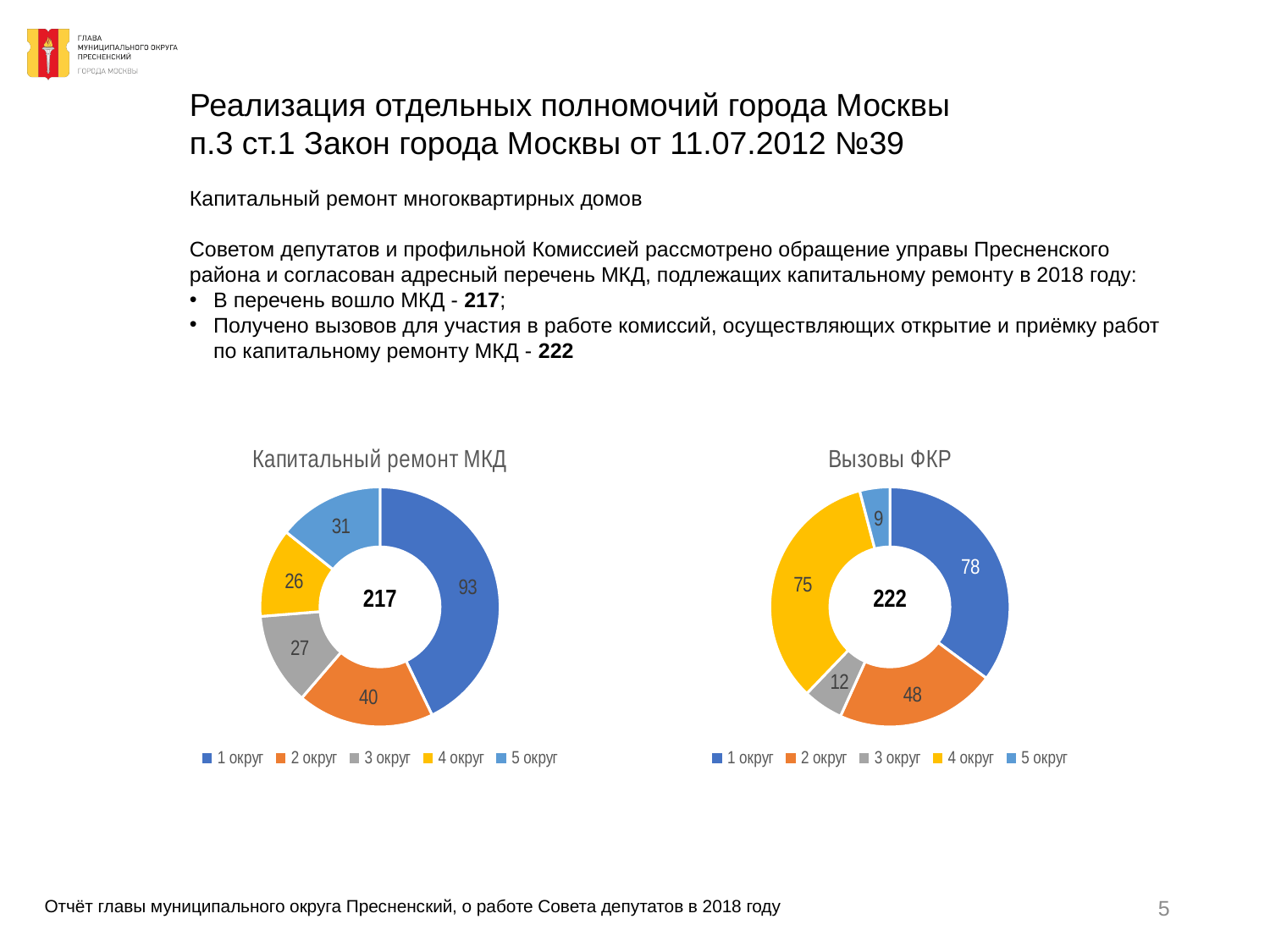
In the chart titled "Капитальный ремонт МКД", which is larger: the value for 2 округ or the value for 5 округ? 2 округ In the chart titled "Вызовы ФКР", which category has the lowest value? 5 округ In the chart titled "Капитальный ремонт МКД", what is the value for 1 округ? 93 What is the title of the chart on the left side of the slide? Капитальный ремонт МКД What type of chart is the chart titled "Вызовы ФКР"? Doughnut chart In the chart titled "Капитальный ремонт МКД", how many categories does the legend list? 5 In the chart titled "Вызовы ФКР", what is the total shown in the centre of the doughnut? 222 In the chart titled "Капитальный ремонт МКД", which category has the highest value? 1 округ In the chart titled "Вызовы ФКР", what is the value for 5 округ? 9 In the chart titled "Вызовы ФКР", what is the value for 4 округ? 75 In the chart titled "Вызовы ФКР", what is the difference between the values for 1 округ and 2 округ? 30 In the chart titled "Капитальный ремонт МКД", what is the value for 3 округ? 27